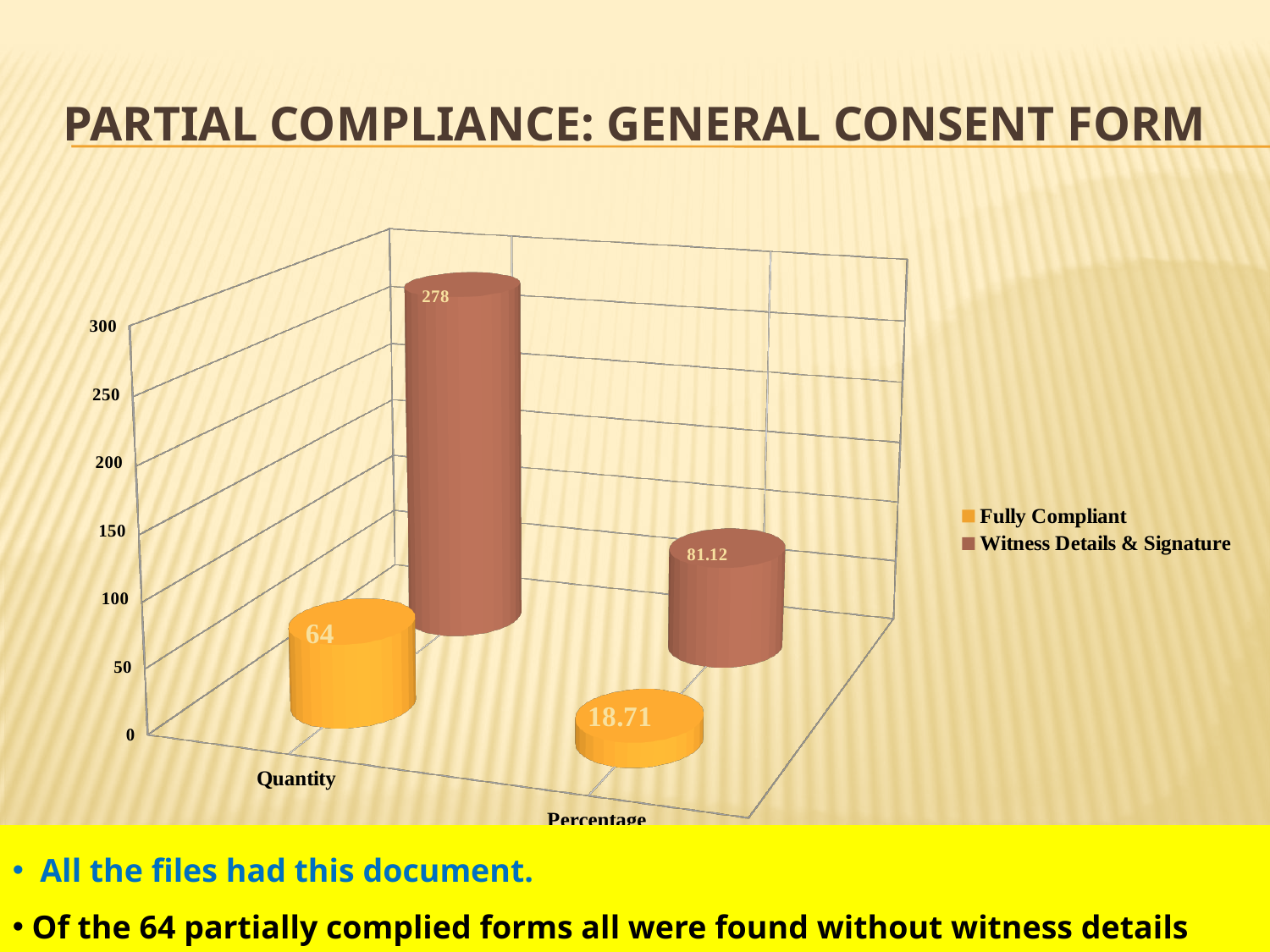
Is the Quantity value for Witness Details & Signature greater or less than 250? greater Is the Percentage value for Fully Compliant greater or less than 50? less What is the title of the slide containing the chart? PARTIAL COMPLIANCE: GENERAL CONSENT FORM What is the Quantity value for Fully Compliant? 64 What kind of chart is shown on the slide? Bar chart Which series has the higher Quantity value? Witness Details & Signature What is the Quantity value for Witness Details & Signature? 278 What is the Percentage value for Fully Compliant? 18.71 How many series does the legend list? 2 What is the difference between the Quantity values for Witness Details & Signature and Fully Compliant? 214 How many categories are shown on the x axis? 2 What is the Percentage value for Witness Details & Signature? 81.12